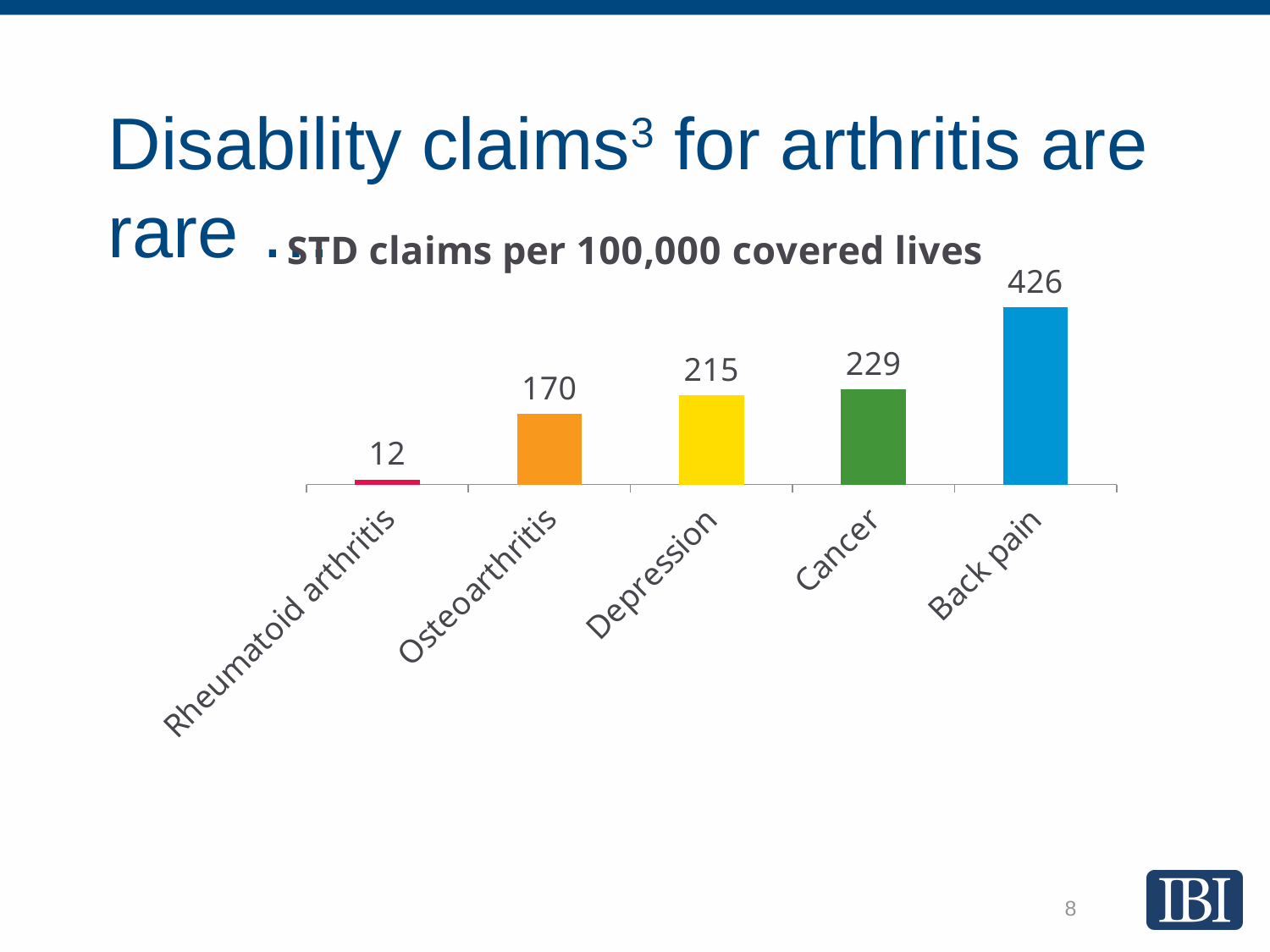
What is the difference between the values for Back pain and Cancer? 197 How many categories are shown in the chart? 5 What is the value for Osteoarthritis? 170 Which category has the highest value? Back pain What is the value for Cancer? 229 Which category has the lowest value? Rheumatoid arthritis What is the difference between the values for Osteoarthritis and Rheumatoid arthritis? 158 What is the value for Depression? 215 What is the value for Back pain? 426 Which is larger, the value for Depression or the value for Osteoarthritis? Depression What kind of chart is shown on the slide? Bar chart What is the value for Rheumatoid arthritis? 12